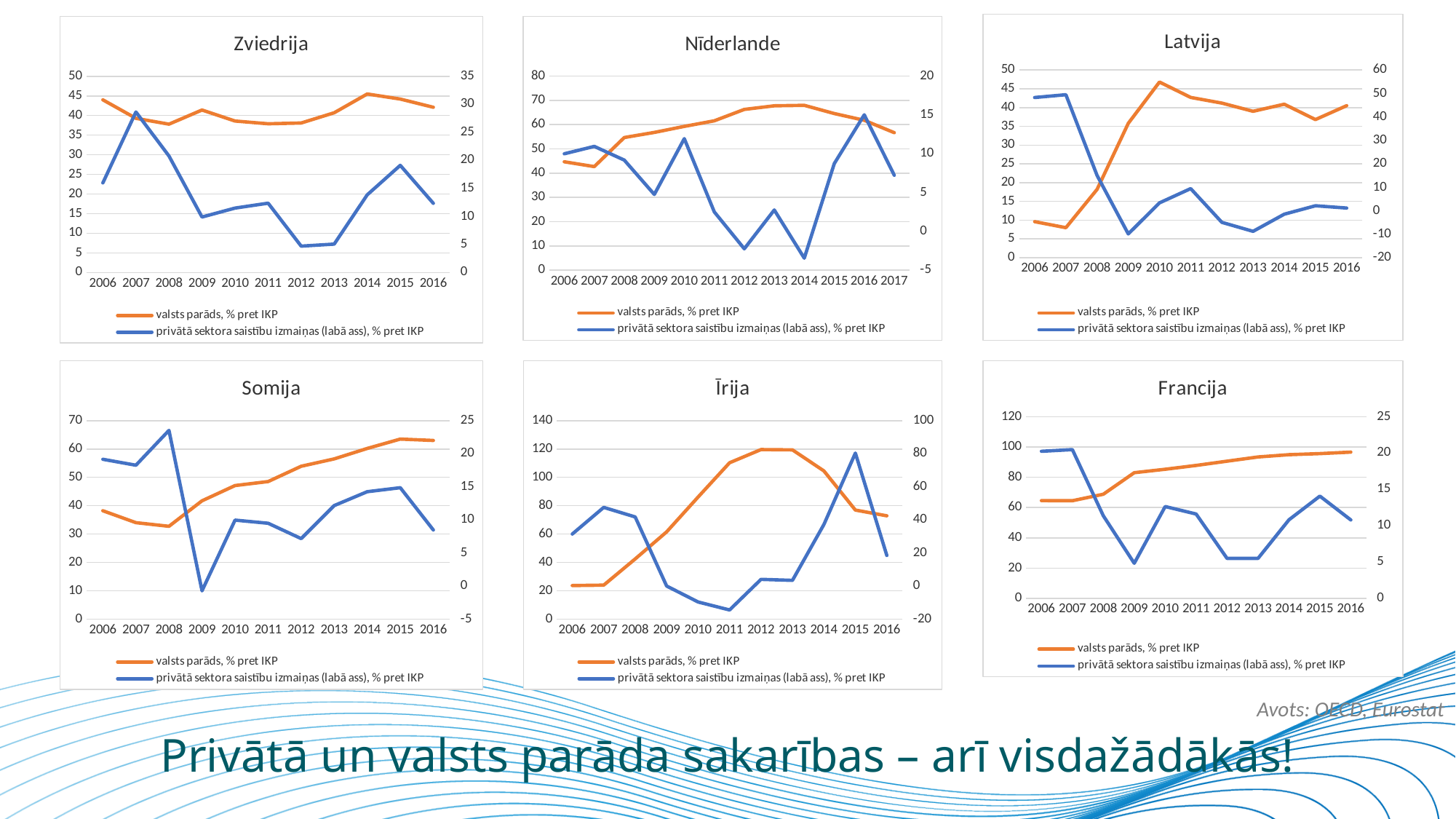
In the Nīderlande chart, is valsts parāds, % pret IKP larger in 2006 or in 2016? 2016 In the Īrija chart, in which year is privātā sektora saistību izmaiņas (labā ass), % pret IKP highest? 2015 In the Īrija chart, is the value of valsts parāds, % pret IKP in 2012 greater or less than 100? greater What kind of chart is the Zviedrija chart? line chart In the Zviedrija chart, is the value of valsts parāds, % pret IKP in 2014 greater or less than 40? greater In the Latvija chart, in which year is valsts parāds, % pret IKP highest? 2010 In the Somija chart, in which year is privātā sektora saistību izmaiņas (labā ass), % pret IKP lowest? 2009 In the Francija chart, does valsts parāds, % pret IKP rise or fall from 2006 to 2016? rises In the Somija chart, which series is drawn in orange? valsts parāds, % pret IKP How many series does the legend of the Latvija chart list? 2 In the Francija chart, is the value of privātā sektora saistību izmaiņas (labā ass), % pret IKP in 2009 greater or less than 10 on the right axis? less In the Nīderlande chart, how many years are shown on the x axis? 12